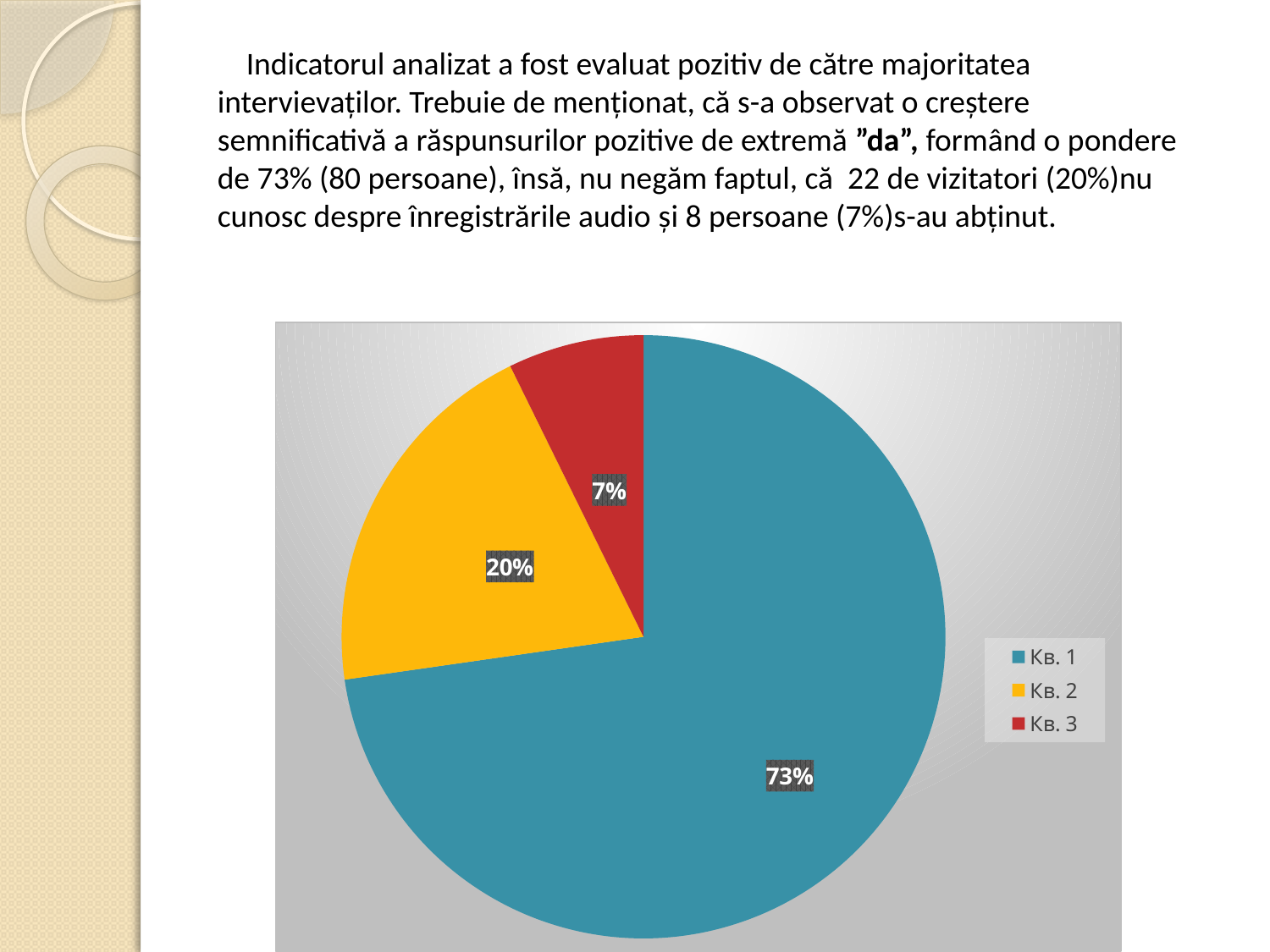
What colour is the slice for Кв. 2? yellow What is the difference in percentage points between Кв. 2 and Кв. 3? 13 What percentage is shown for Кв. 3? 7% What percentage is shown for Кв. 2? 20% What is the difference in percentage points between Кв. 1 and Кв. 2? 53 Which slice of the pie is the smallest? Кв. 3 Which is larger, the slice for Кв. 2 or the slice for Кв. 3? Кв. 2 Which slice of the pie is the largest? Кв. 1 How many slices does the pie chart have? 3 How many entries does the legend list? 3 What percentage is shown for Кв. 1? 73% What kind of chart is shown on the slide? pie chart